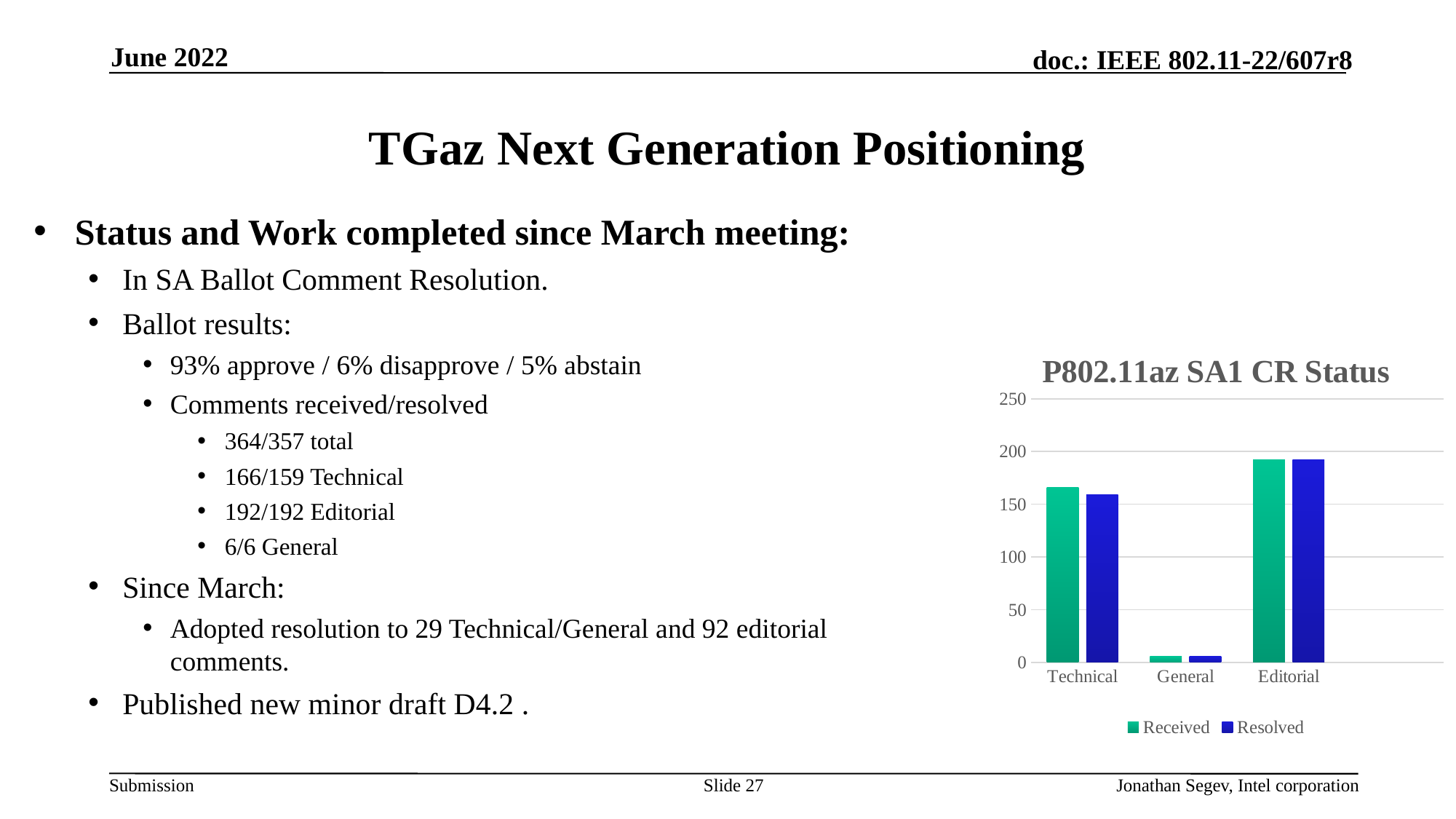
Is the Resolved value for Technical greater or less than 100? greater How many categories are shown on the x axis of the P802.11az SA1 CR Status chart? 3 Is the Received value for Editorial greater or less than 200? less Is the Resolved value for General greater or less than 50? less For Technical, which is larger: Received or Resolved? Received Which category has the highest Received value in the P802.11az SA1 CR Status chart? Editorial What is the title of the chart on the slide? P802.11az SA1 CR Status How many series does the legend of the P802.11az SA1 CR Status chart list? 2 What kind of chart is the P802.11az SA1 CR Status chart? bar chart Which series is shown in blue in the P802.11az SA1 CR Status chart? Resolved Which category has the lowest Resolved value in the P802.11az SA1 CR Status chart? General